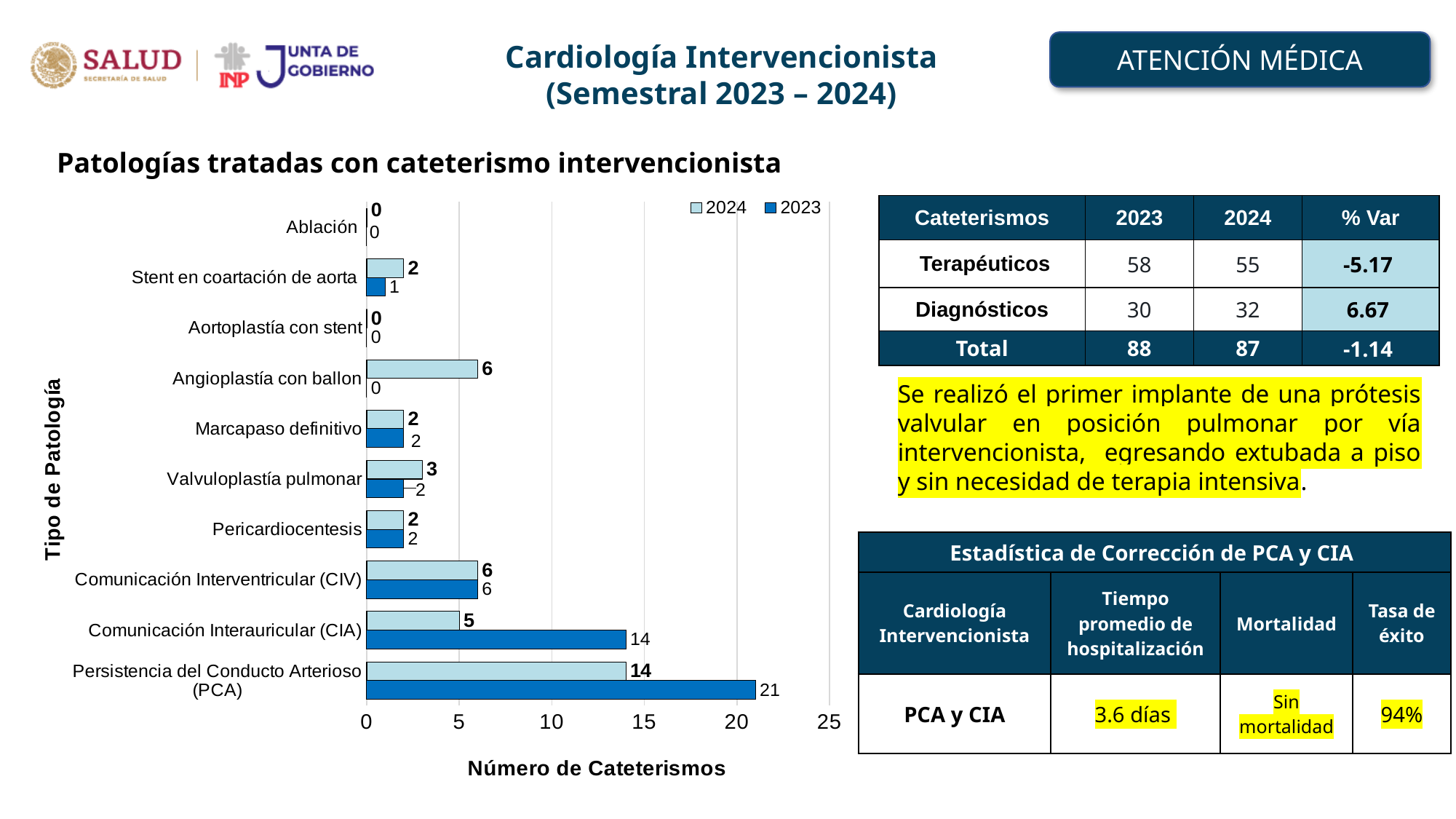
Which pathology has the highest 2023 value? Persistencia del Conducto Arterioso (PCA) What is the 2023 value for Stent en coartación de aorta? 1 What type of chart is shown on the slide? bar chart What is the 2024 value for Angioplastía con ballon? 6 What is the 2023 value for Persistencia del Conducto Arterioso (PCA)? 21 How many pathology categories are shown on the chart? 10 What is the 2024 value for Comunicación Interauricular (CIA)? 5 Which is larger for Persistencia del Conducto Arterioso (PCA): the 2023 value or the 2024 value? 2023 What is the label of the x axis of the chart? Número de Cateterismos What is the difference between the 2023 and 2024 values for Comunicación Interauricular (CIA)? 9 Is the 2023 value for Persistencia del Conducto Arterioso (PCA) greater or less than 20? greater How many series does the chart legend list? 2